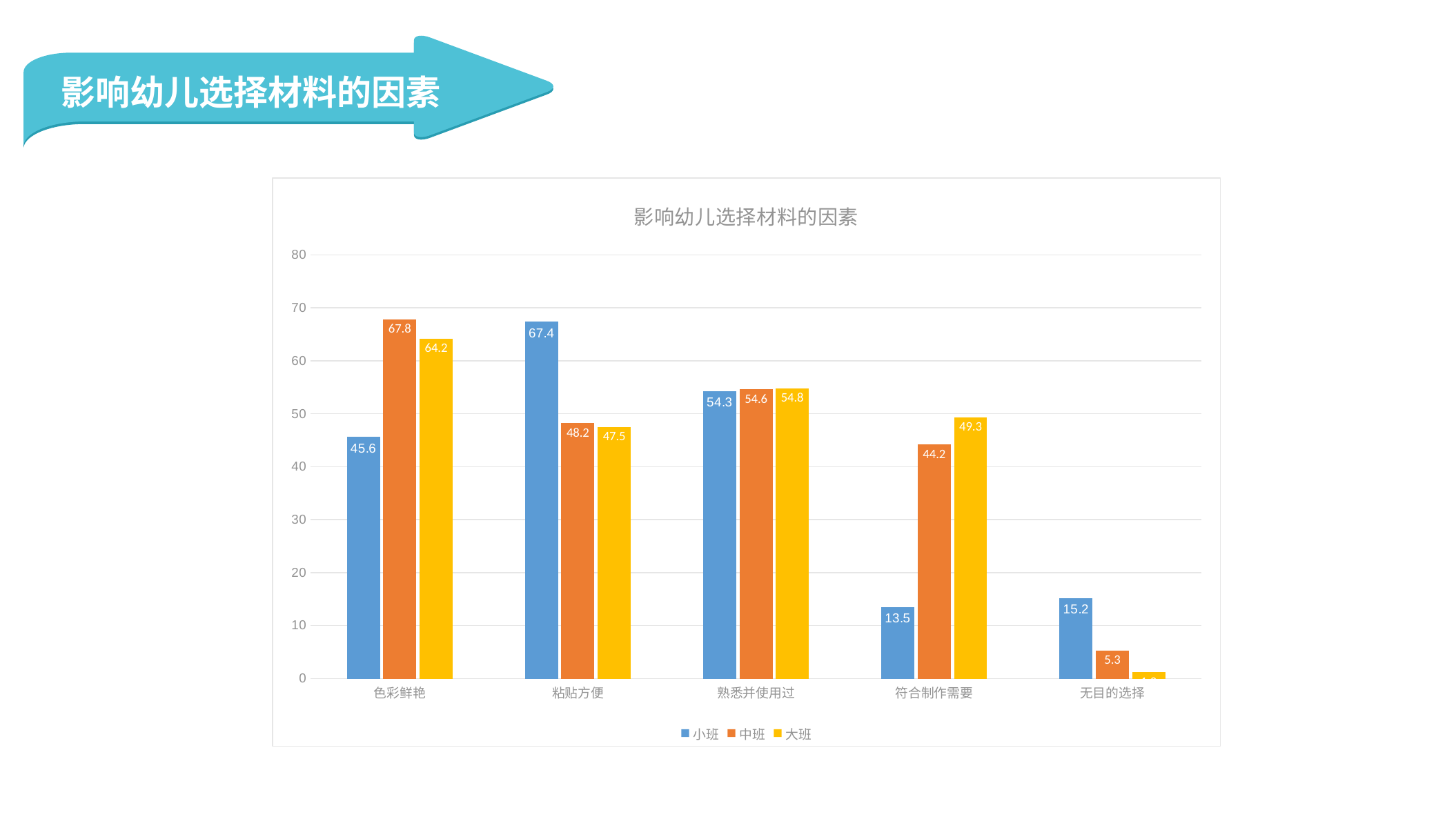
What type of chart is shown on the slide? bar chart How many categories are shown on the x axis? 5 What is the title of the chart? 影响幼儿选择材料的因素 What is the value for 小班 in the 色彩鲜艳 category? 45.6 What is the value for 大班 in the 粘贴方便 category? 47.5 Is the value for 小班 in the 无目的选择 category greater or less than 20? less In the 符合制作需要 category, which is larger: the 大班 value or the 小班 value? 大班 How many series does the legend list? 3 What is the value for 中班 in the 符合制作需要 category? 44.2 Which category has the lowest value for the 中班 series? 无目的选择 What is the difference between the 中班 and 小班 values in the 色彩鲜艳 category? 22.2 Which category has the highest value for the 小班 series? 粘贴方便